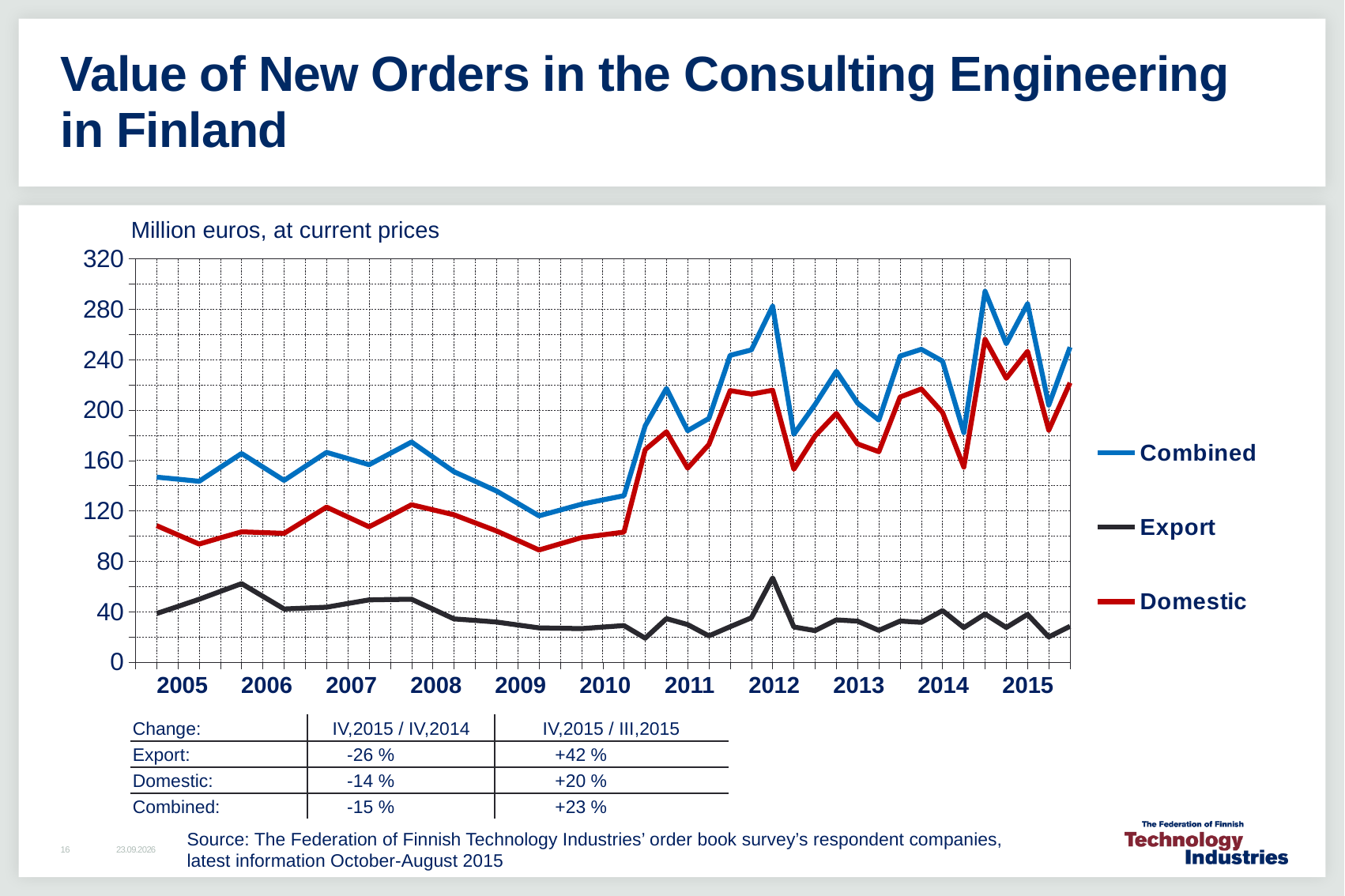
What unit is stated above the chart? Million euros, at current prices Which series has the lowest values throughout the chart? Export What kind of chart is shown on the slide? Line chart How many years are labelled on the x axis? 11 Is the Domestic value in 2009 greater or less than 120? less Does the Combined series overall rise or fall from 2005 to 2015? rise Which series are listed in the chart legend? Combined, Export, Domestic How many series does the legend list? 3 In 2012, which is larger, the Domestic value or the Export value? Domestic Which series has the highest values throughout the chart? Combined Is the highest value of the Export series greater or less than 80? less Is the peak value of the Combined series in 2014 greater or less than 280? greater